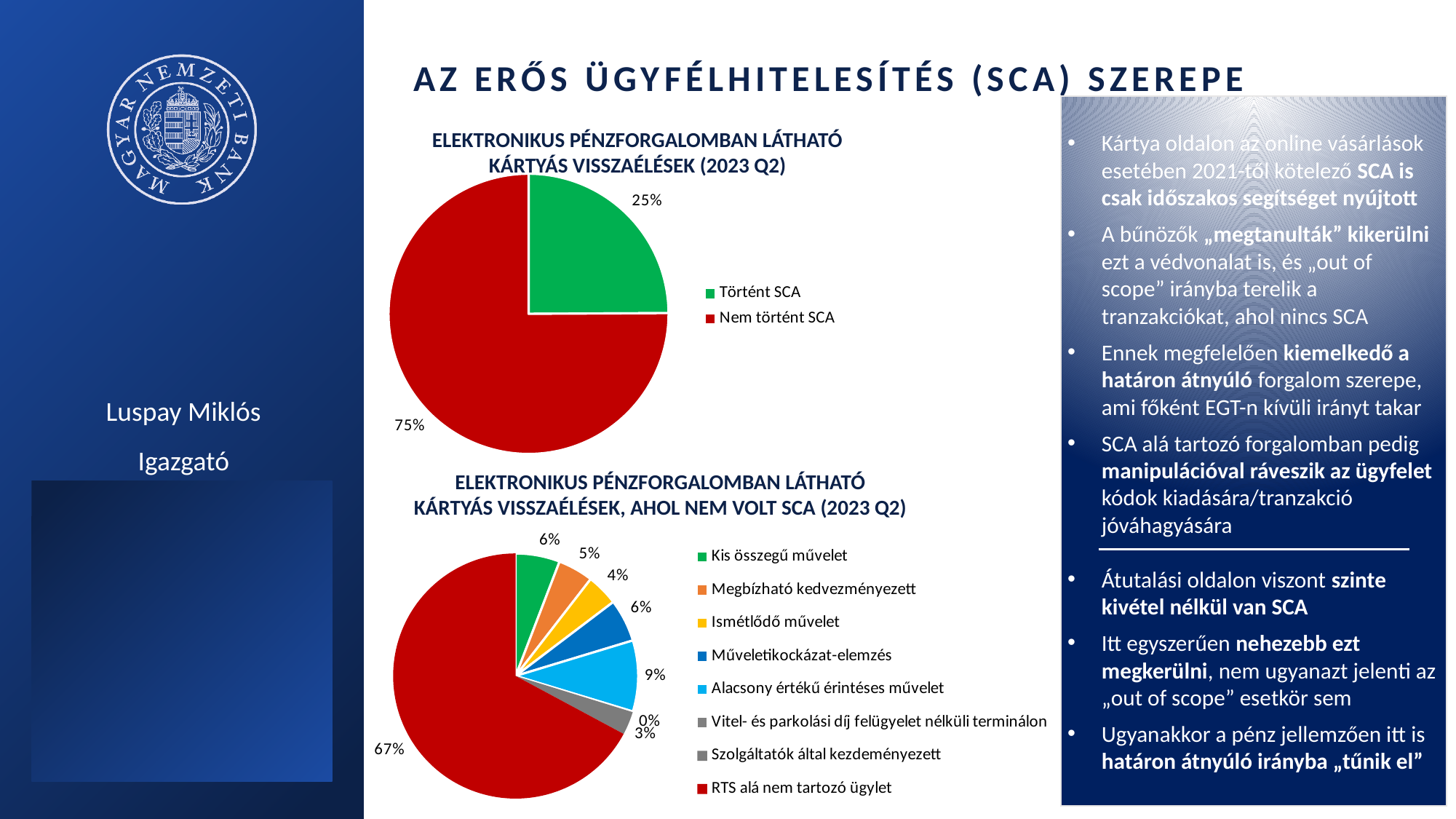
In the top chart (Elektronikus pénzforgalomban látható kártyás visszaélések, 2023 Q2), what share is labelled for Történt SCA? 25% In the top chart (Elektronikus pénzforgalomban látható kártyás visszaélések, 2023 Q2), what share is labelled for Nem történt SCA? 75% In the top chart, which category has the larger share: Történt SCA or Nem történt SCA? Nem történt SCA In the bottom chart (ahol nem volt SCA, 2023 Q2), what share is labelled for Alacsony értékű érintéses művelet? 9% How many entries does the legend of the top chart list? 2 In the bottom chart (ahol nem volt SCA, 2023 Q2), what share is labelled for Szolgáltatók által kezdeményezett? 3% How many categories does the legend of the bottom chart list? 8 In the top chart, what is the difference in percentage points between Nem történt SCA and Történt SCA? 50 percentage points In the bottom chart (ahol nem volt SCA, 2023 Q2), what share is labelled for RTS alá nem tartozó ügylet? 67% In the bottom chart, which category has the smallest share? Vitel- és parkolási díj felügyelet nélküli terminálon What type of chart is the bottom chart (kártyás visszaélések, ahol nem volt SCA)? Pie chart In the bottom chart, which category has the largest share? RTS alá nem tartozó ügylet